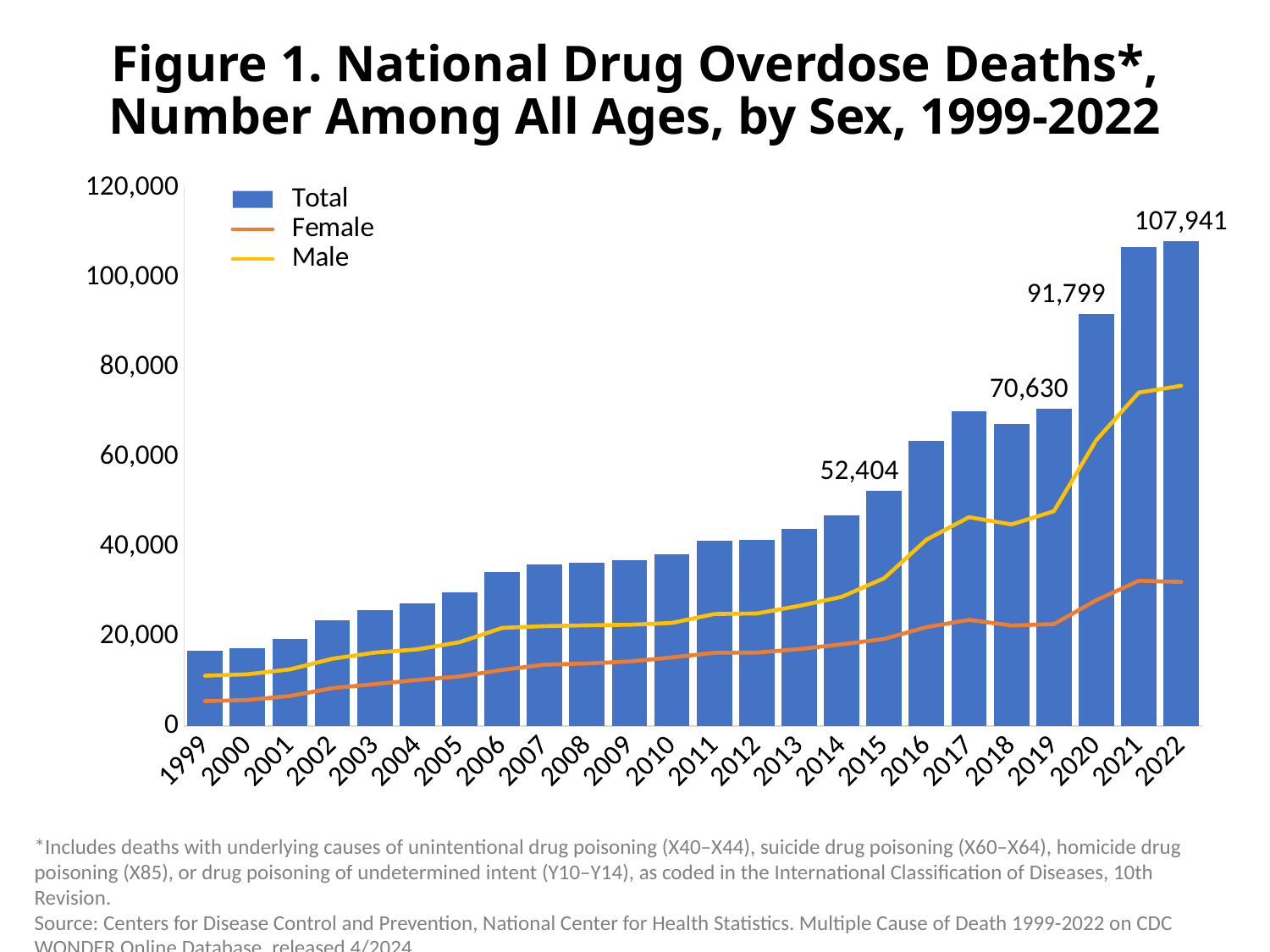
How many series does the legend list? 3 What is the total number of drug overdose deaths in 2022? 107,941 How many years are shown on the x axis? 24 What is the total number of drug overdose deaths in 2020? 91,799 What is the difference between the total deaths in 2022 and in 2020? 16,142 Is the Male value for 2022 greater or less than 60,000? greater Is the total number of deaths in 1999 greater or less than 20,000? less Which year has more total drug overdose deaths, 2017 or 2020? 2020 Which year has the highest total number of drug overdose deaths? 2022 What is the total number of drug overdose deaths in 2015? 52,404